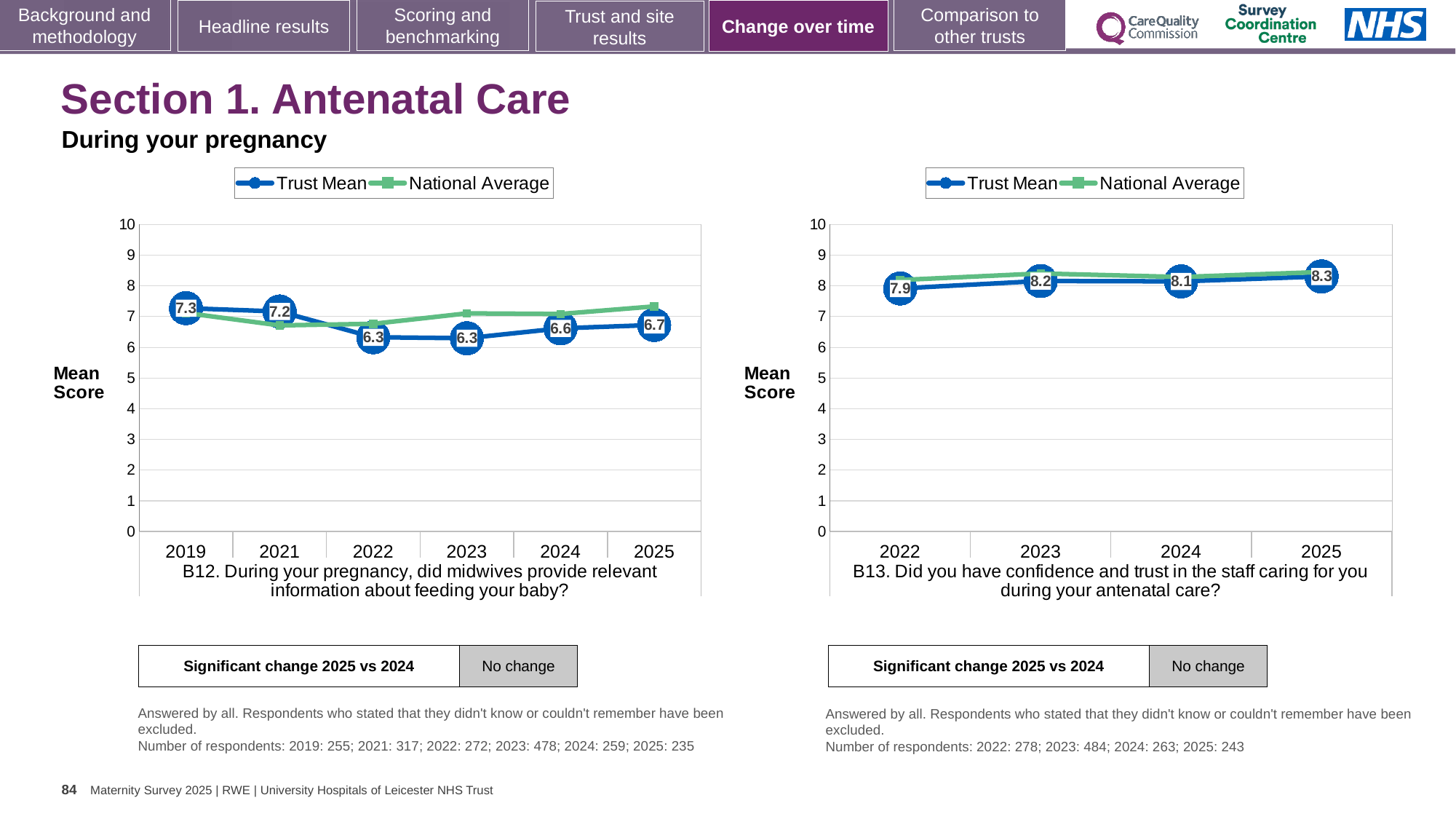
In the B12 chart (left), what is the difference between the Trust Mean in 2019 and in 2025? 0.6 In the B12 chart (left), what is the Trust Mean for 2025? 6.7 In the B13 chart (right), what is the Trust Mean for 2022? 7.9 How many series does the legend of the B13 chart (right) list? 2 In the B12 chart (left), what is the Trust Mean for 2019? 7.3 In the B12 chart (left), which year has the highest Trust Mean? 2019 In the B13 chart (right), which year has the highest Trust Mean? 2025 In the B13 chart (right), which is larger, the Trust Mean for 2023 or for 2024? 2023 How many years are shown on the x axis of the B12 chart (left)? 6 What kind of chart is the B13 chart (right)? Line chart In the B12 chart (left), is the National Average for 2025 greater or less than 7? greater In the B13 chart (right), which year has the lowest Trust Mean? 2022